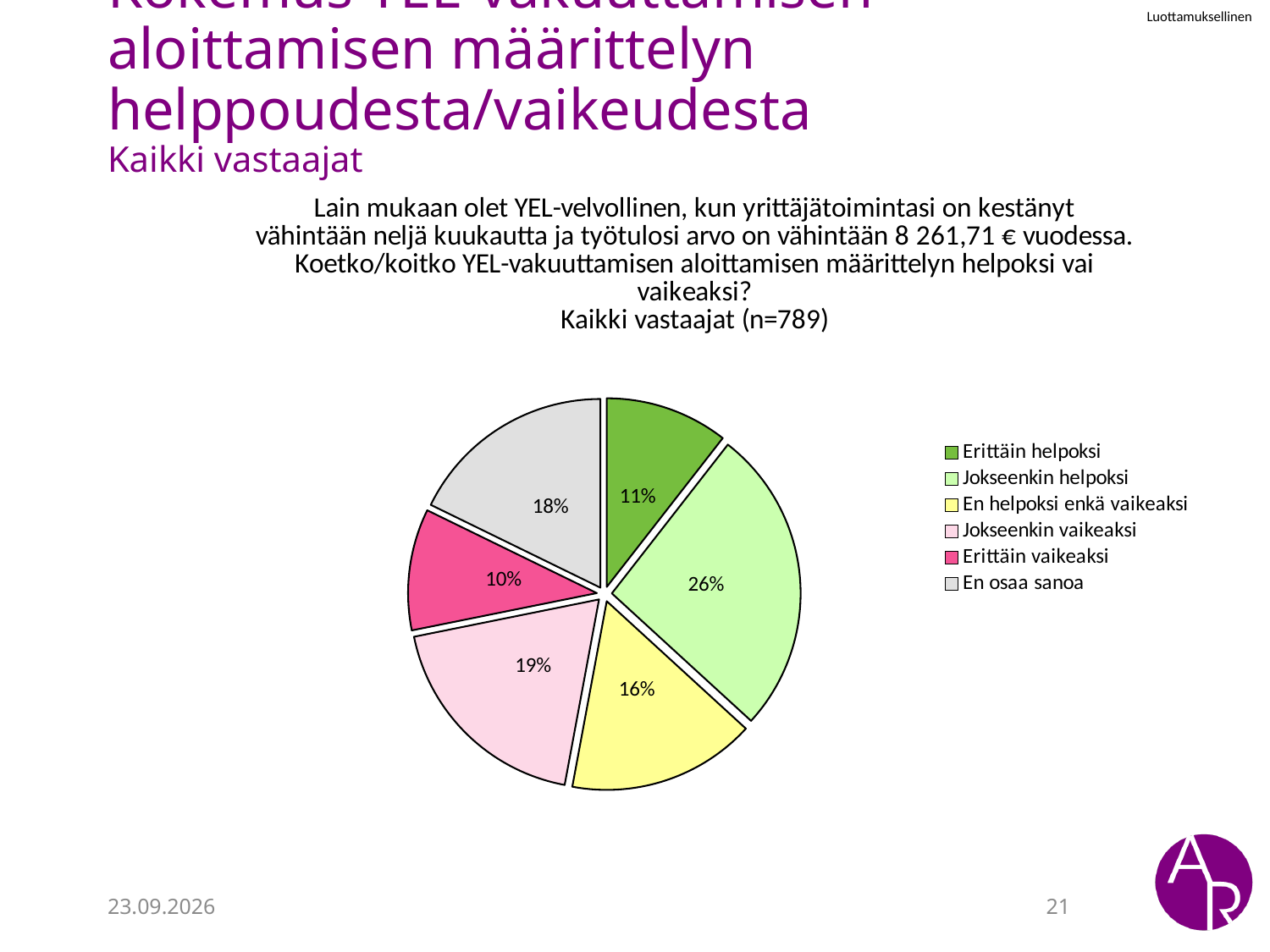
Which response category has the smallest share of the pie? Erittäin vaikeaksi How many respondents (n) does the chart subtitle state? 789 What percentage of respondents answered "Jokseenkin vaikeaksi"? 19% Which is larger, the share for "Jokseenkin vaikeaksi" or the share for "En helpoksi enkä vaikeaksi"? Jokseenkin vaikeaksi What kind of chart is shown on the slide? Pie chart What is the combined share of "Erittäin helpoksi" and "Jokseenkin helpoksi"? 37% What percentage of respondents answered "Erittäin helpoksi"? 11% Which response category has the largest share of the pie? Jokseenkin helpoksi How many categories does the legend list? 6 What is the difference in percentage points between "Jokseenkin helpoksi" and "Erittäin helpoksi"? 15 percentage points What percentage of respondents answered "En osaa sanoa"? 18% What percentage of respondents answered "Jokseenkin helpoksi"? 26%